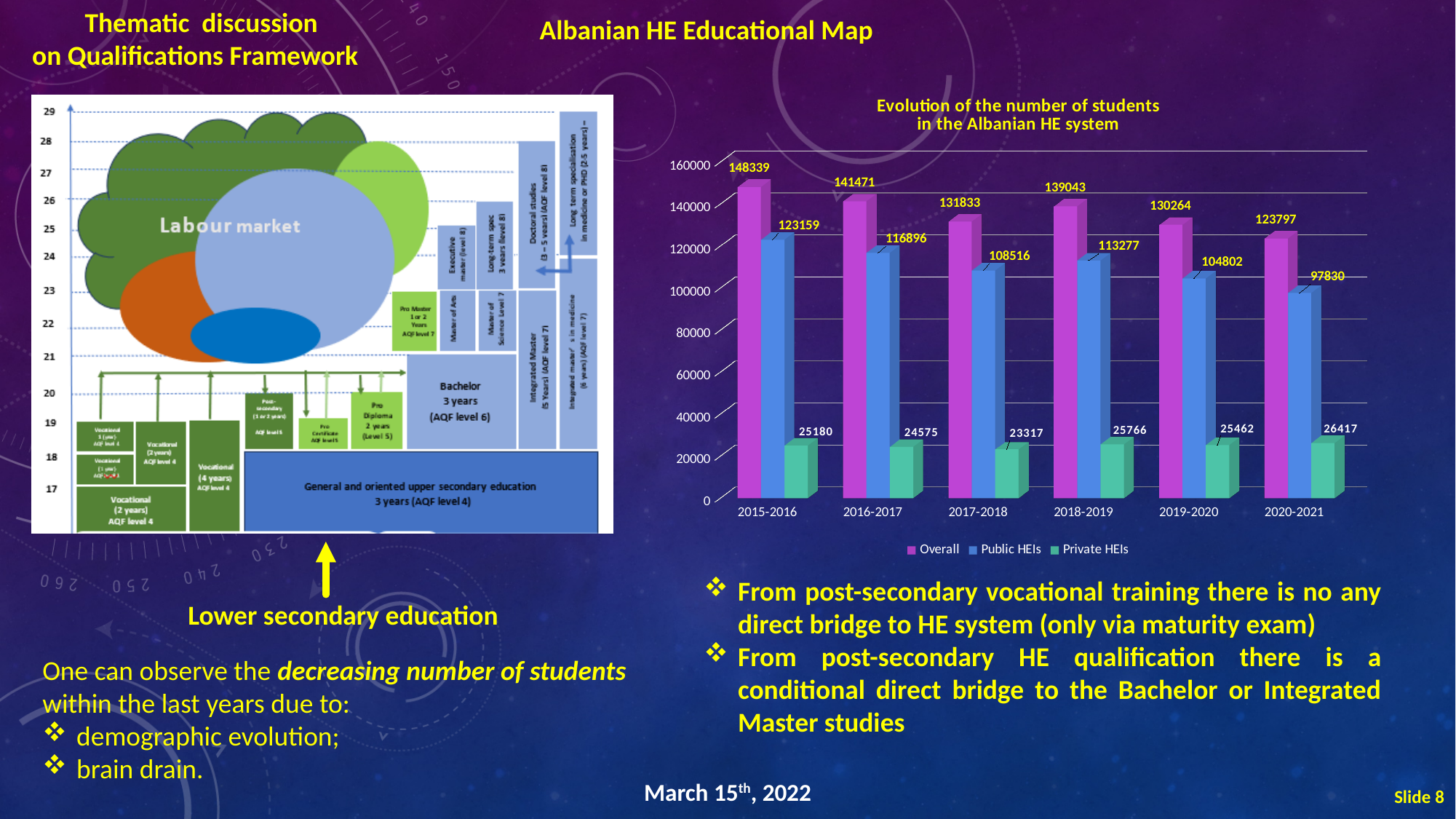
What is the Overall number of students in 2015-2016? 148339 What is the value for Public HEIs in 2020-2021? 97830 How many academic years are shown on the x axis? 6 In which academic year is the Private HEIs value lowest? 2017-2018 Is the Public HEIs value for 2020-2021 greater or less than 100000? less Which is larger: Public HEIs in 2016-2017 or Public HEIs in 2018-2019? Public HEIs in 2016-2017 In which academic year is the Overall number of students highest? 2015-2016 What is the value for Private HEIs in 2017-2018? 23317 What is the difference between the Overall value and the Public HEIs value in 2019-2020? 25462 What kind of chart is shown? bar chart How many series does the legend list? 3 What is the title of the chart? Evolution of the number of students in the Albanian HE system